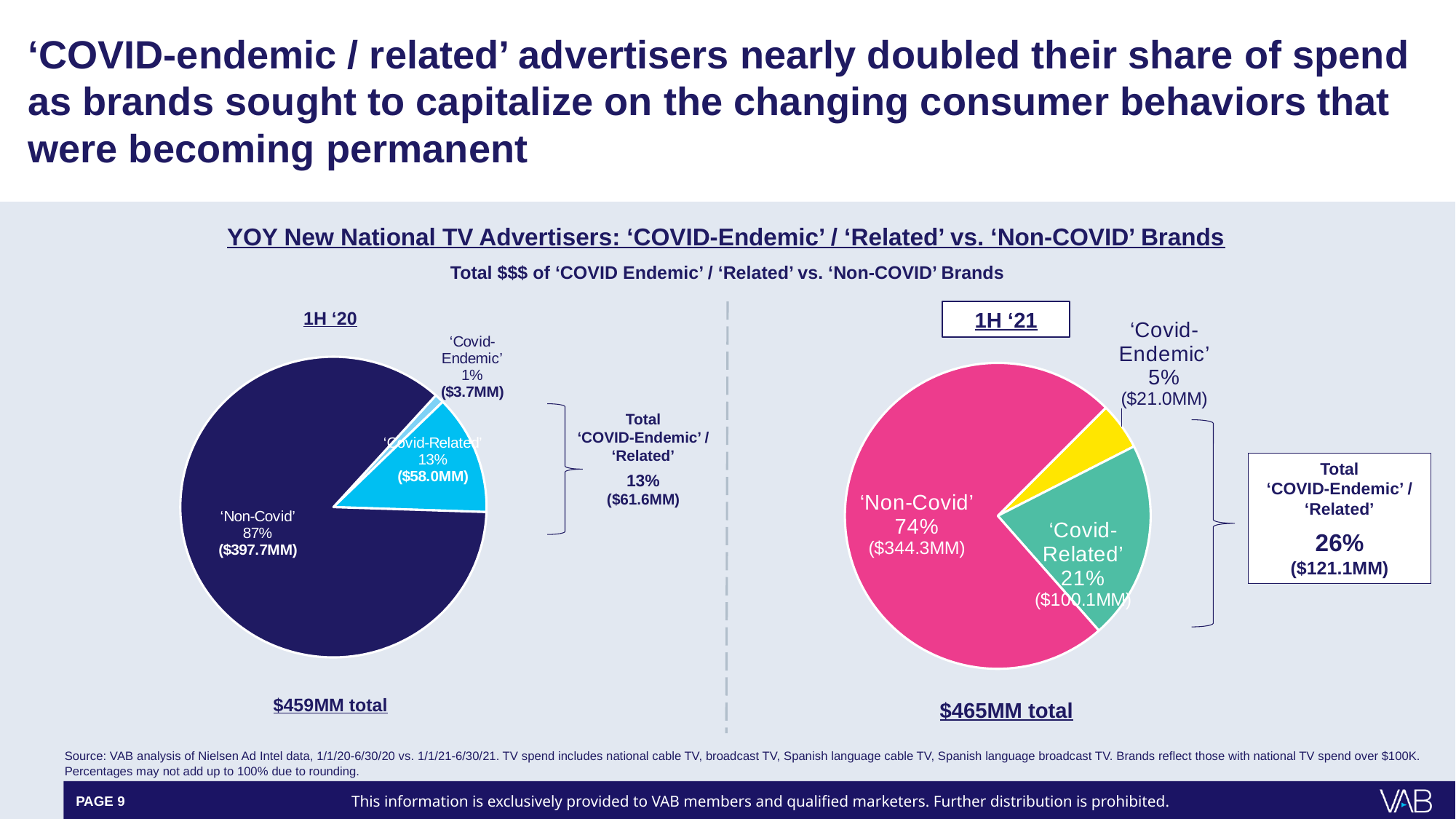
In the 1H '20 pie chart, what share of spend is 'Non-Covid'? 87% In the 1H '21 pie chart, what is the dollar value for 'Non-Covid'? $344.3MM What is the difference in dollar value between 'Covid-Related' in 1H '21 and 'Covid-Related' in 1H '20? $42.1MM In the 1H '21 pie chart, which slice is the smallest? 'Covid-Endemic' How many slices does the 1H '21 pie chart have? 3 What type of chart is used to show the 1H '20 data? Pie chart In the 1H '20 pie chart, what is the dollar value for 'Covid-Related'? $58.0MM In the 1H '20 pie chart, which slice is the largest? 'Non-Covid' What is the total spend shown below the 1H '21 pie chart? $465MM total In the 1H '20 pie chart, what is the dollar value for 'Covid-Endemic'? $3.7MM In the 1H '21 pie chart, what share of spend is 'Covid-Related'? 21% Which is larger: the 'Covid-Endemic' share in 1H '20 or in 1H '21? 1H '21